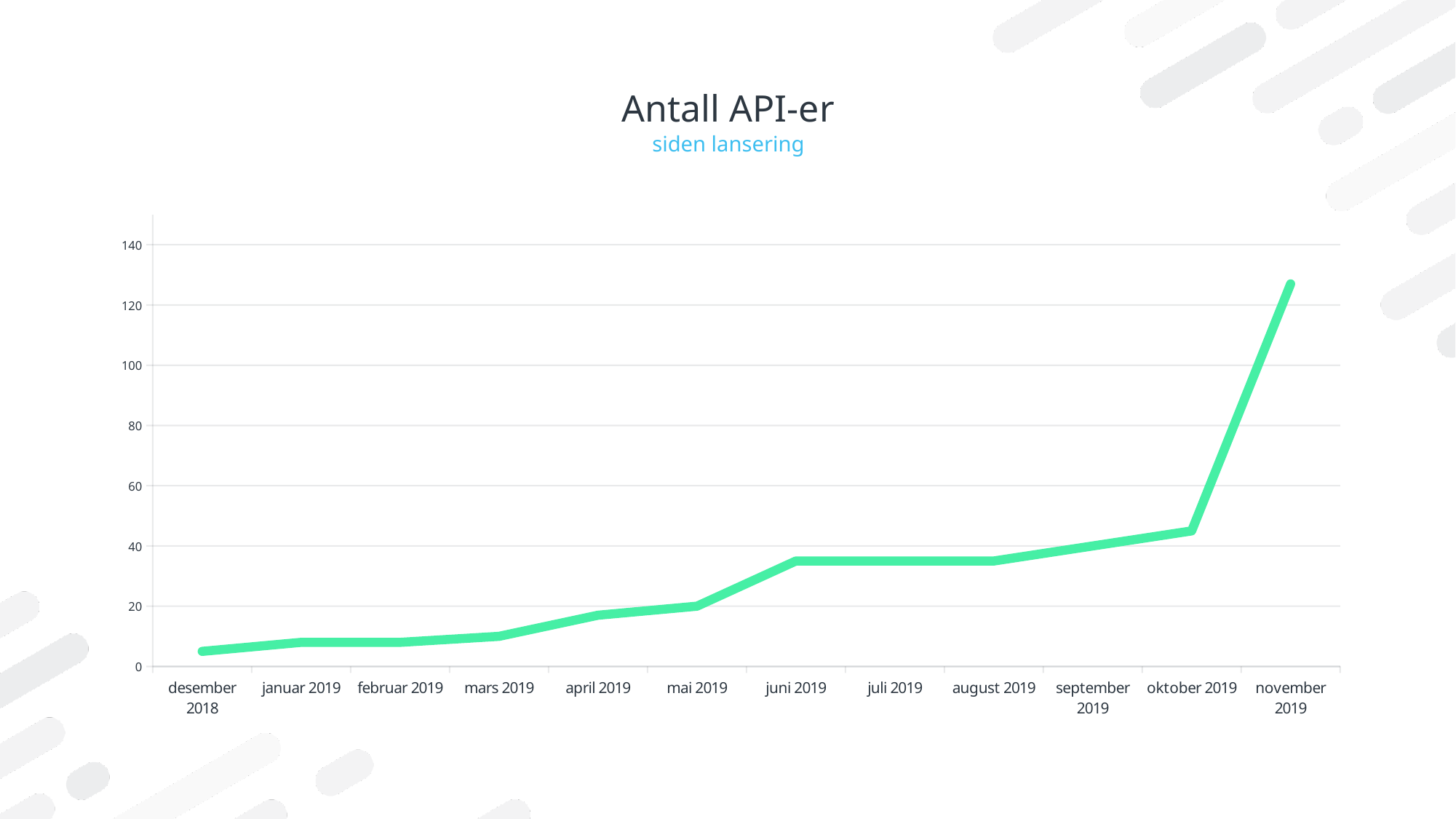
Do the values rise or fall from desember 2018 to november 2019? rise Is the value for juni 2019 greater or less than 20? greater Is the value for desember 2018 greater or less than 20? less Is the value for november 2019 greater or less than 120? greater What kind of chart is shown on the slide? line chart Which month has the highest number of APIs? november 2019 How many months are plotted on the x axis? 12 What is the subtitle shown under the chart title? siden lansering What is the title of the chart? Antall API-er Which month has the lowest number of APIs? desember 2018 Which is larger, the value for november 2019 or the value for oktober 2019? november 2019